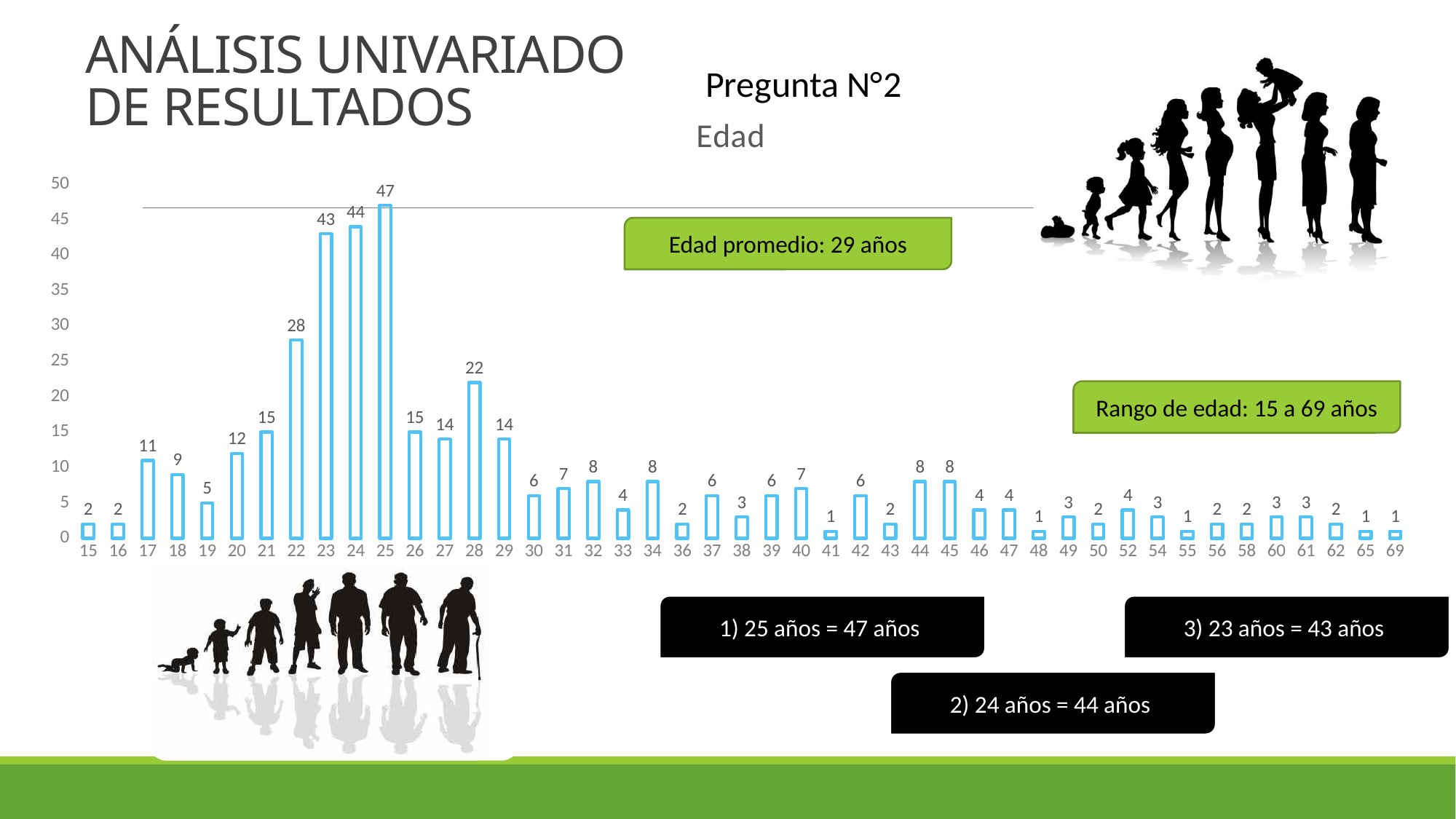
What is the difference between the values for age 24 and age 22? 16 How many age categories are shown on the x axis? 45 What is the value for age 17? 11 Which is larger, the value for age 21 or the value for age 29? 21 Which age has the highest value? 25 Which is larger, the value for age 18 or the value for age 20? 20 What is the value for age 22? 28 What is the title shown above the chart? Edad What kind of chart is shown on the slide? bar chart What is the difference between the values for age 25 and age 23? 4 What is the value for age 28? 22 Do the values generally rise or fall from age 25 to age 30? fall